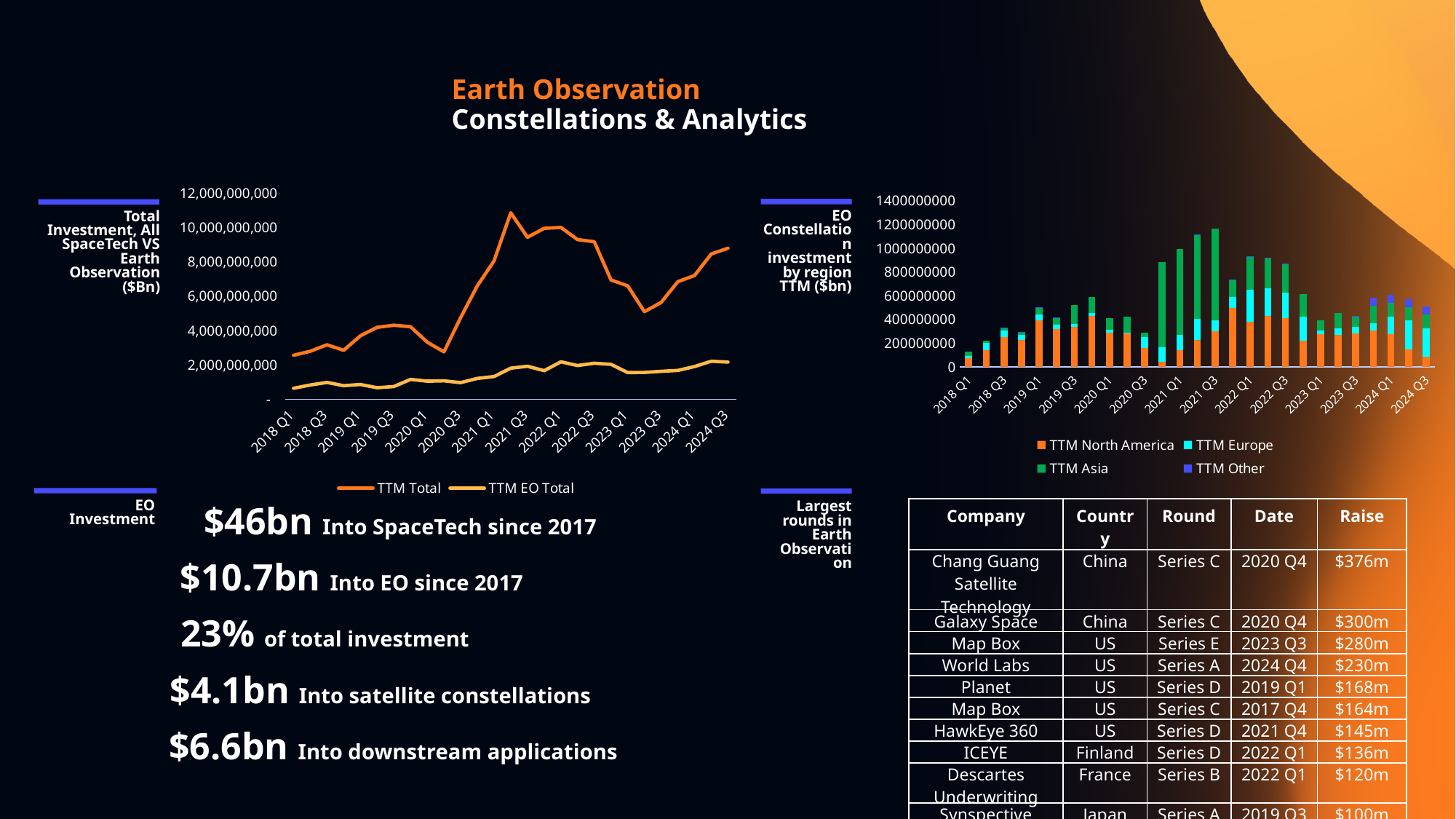
In the right bar chart, is the total stacked value at 2018 Q1 greater or less than 200000000? less In the right bar chart, at which x-axis label is the tallest stacked bar? 2021 Q3 In the right bar chart, do the stacked bar totals rise or fall from 2021 Q3 to 2023 Q1? fall In the left line chart, which series is higher at 2021 Q3, TTM Total or TTM EO Total? TTM Total How many series does the legend of the right bar chart list? 4 How many series does the legend of the left line chart list? 2 What kind of chart is the left chart titled 'Total Investment, All SpaceTech VS Earth Observation ($Bn)'? Line chart In the left line chart, is the TTM Total value at 2021 Q3 greater or less than 10,000,000,000? less In the right bar chart, which series is shown in green? TTM Asia What kind of chart is the right chart titled 'EO Constellation investment by region TTM ($bn)'? Stacked bar chart In the left line chart, is the TTM Total value at 2018 Q1 greater or less than 4,000,000,000? less In the left line chart, does the TTM Total series rise or fall between 2020 Q3 and 2021 Q3? rise